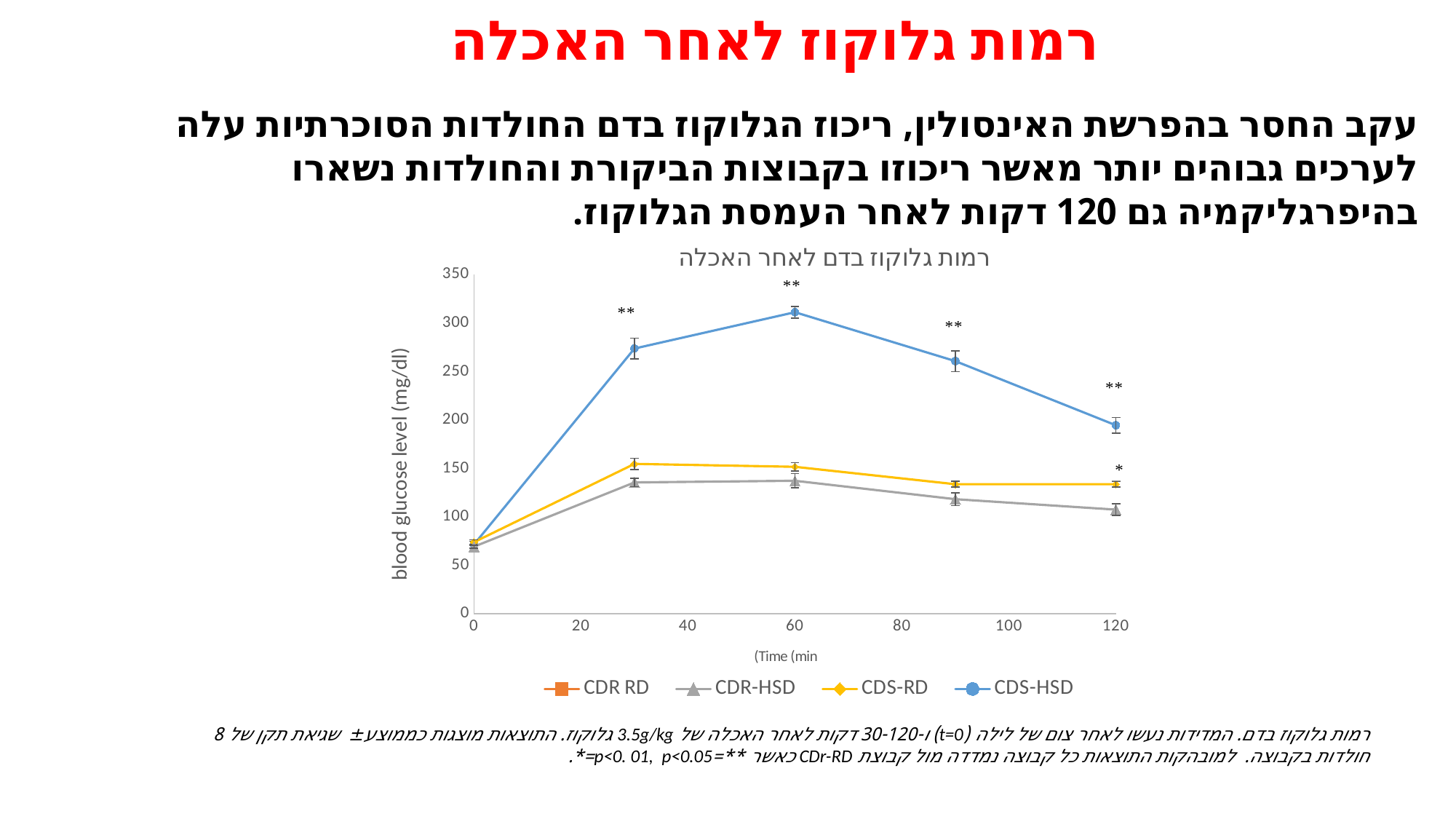
What kind of chart is shown on the slide? line chart How many time points are plotted for each series in the chart? 5 Is the value for CDS-HSD at 60 minutes greater or less than 300? greater At which time point does the CDS-HSD series reach its peak? 60 How many series does the chart legend list? 4 Which series has the highest blood glucose level at 60 minutes? CDS-HSD Which is larger at 90 minutes, the value for CDS-HSD or the value for CDR-HSD? CDS-HSD Is the value for CDS-HSD at 120 minutes greater or less than 200? less What is the label of the y axis of the chart? blood glucose level (mg/dl) Is the value for CDR-HSD at 30 minutes greater or less than 150? less Does the CDS-HSD series rise or fall between 60 and 120 minutes? fall